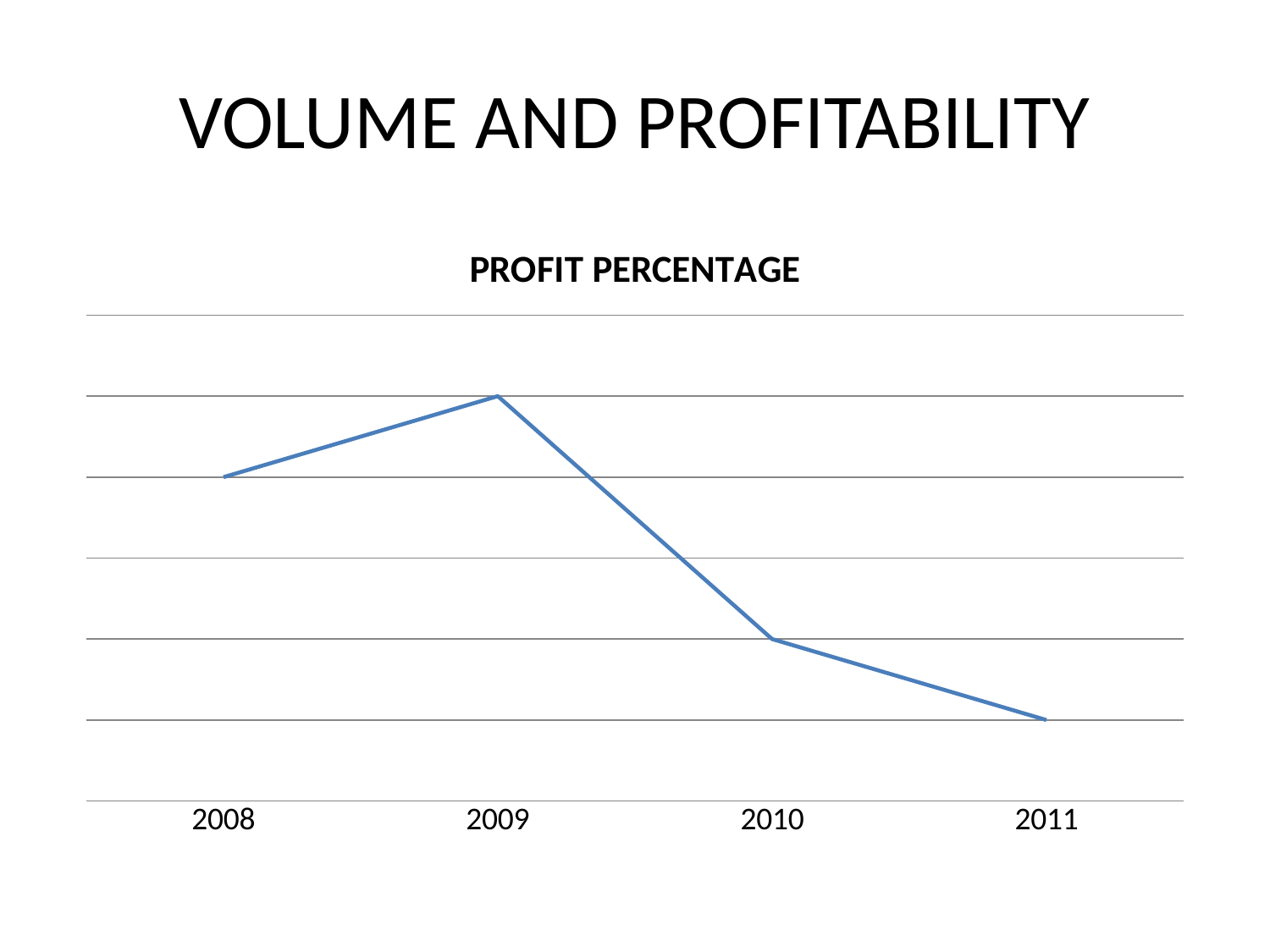
What kind of chart is shown on the slide? line chart Does the profit percentage rise or fall from 2009 to 2011? fall How many years are plotted on the x axis of the chart? 4 Does the profit percentage rise or fall from 2008 to 2009? rise Which year has the higher profit percentage, 2008 or 2010? 2008 Which year has the highest profit percentage? 2009 Which year has the higher profit percentage, 2010 or 2011? 2010 What is the first year shown on the x axis? 2008 Which year has the lowest profit percentage? 2011 Which year has the higher profit percentage, 2009 or 2011? 2009 What is the title of the chart? PROFIT PERCENTAGE